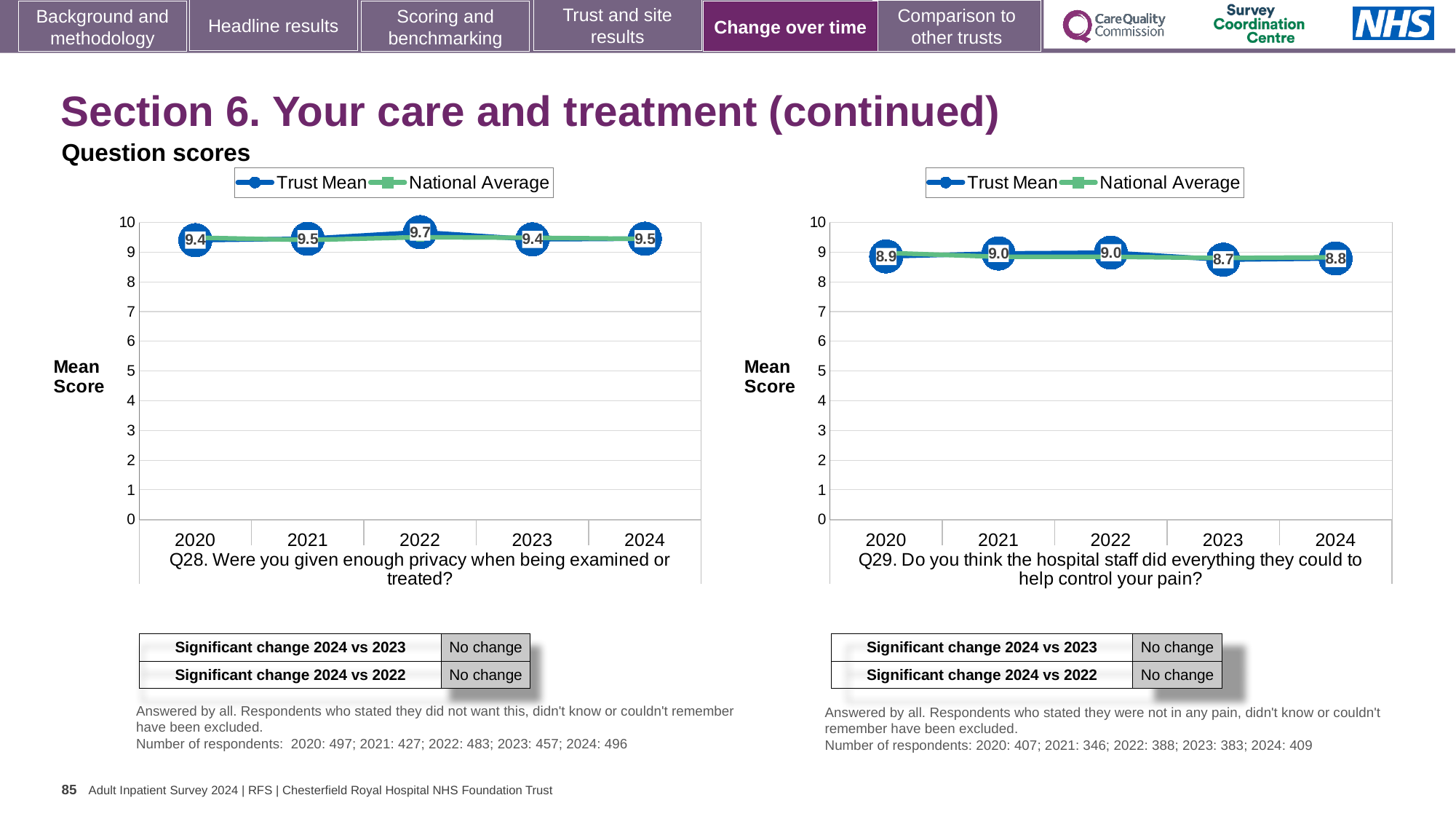
In the Q28 chart (left), what is the difference between the Trust Mean scores for 2022 and 2023? 0.3 In the Q28 chart (left), is the Trust Mean value for 2024 greater or less than 8? greater In the Q29 chart (right), is the Trust Mean score higher in 2021 or in 2024? 2021 How many series does the legend of the Q28 chart (left) list? 2 In the Q29 chart (right), what is the difference between the Trust Mean scores for 2020 and 2023? 0.2 In the Q29 chart (right), which year has the lowest Trust Mean score? 2023 In the Q29 chart (right), what is the Trust Mean score for 2023? 8.7 In the Q28 chart (left), which year has the highest Trust Mean score? 2022 How many years are shown on the x axis of the Q29 chart (right)? 5 In the Q28 chart (left), what is the Trust Mean score for 2022? 9.7 In the Q29 chart (right), what does the table say about the significant change 2024 vs 2023? No change What type of chart is used for Q28 (left)? Line chart